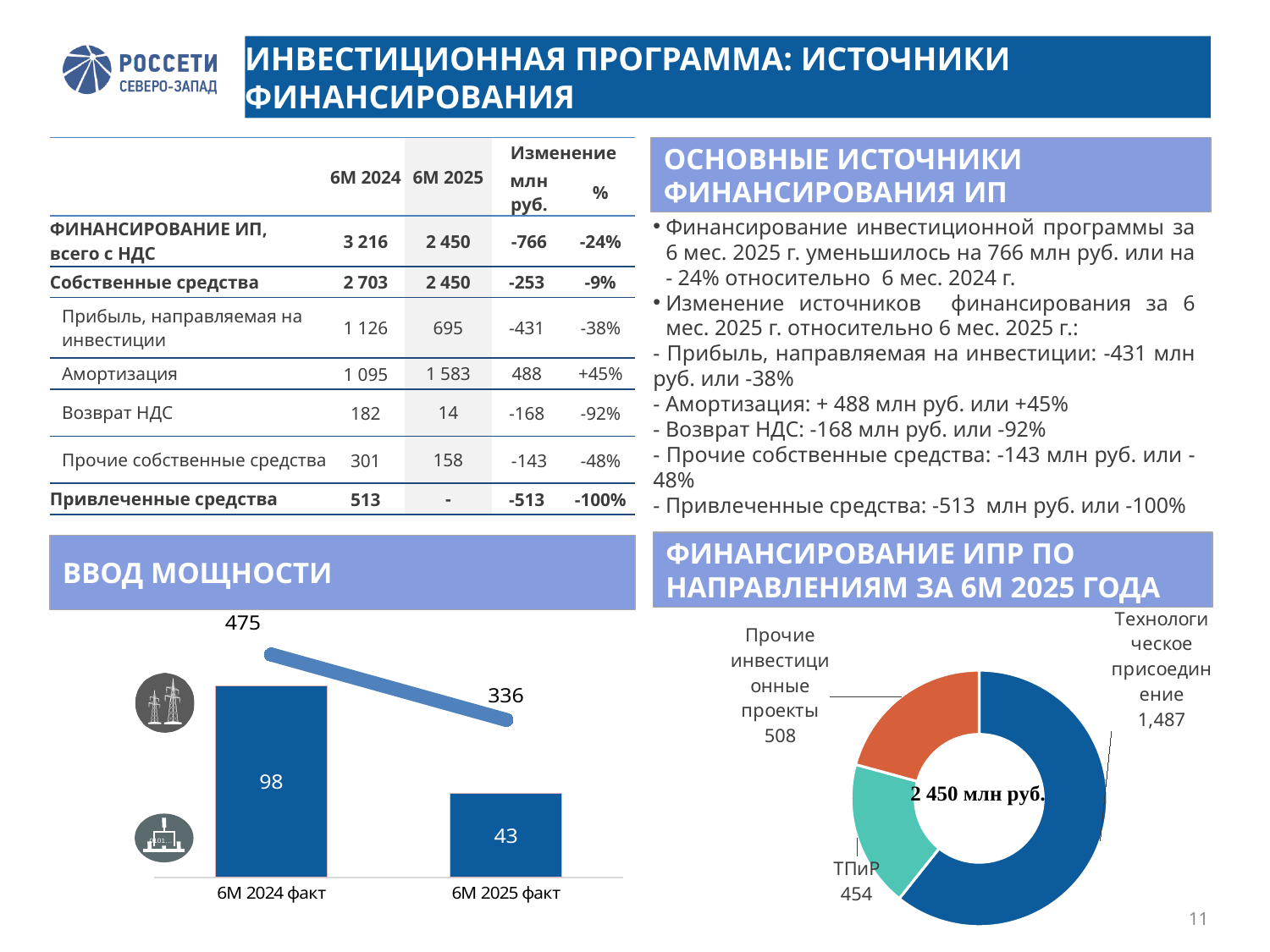
In the 'ФИНАНСИРОВАНИЕ ИПР ПО НАПРАВЛЕНИЯМ ЗА 6М 2025 ГОДА' chart, which segment is the smallest? ТПиР In the 'ВВОД МОЩНОСТИ' chart, what value is labelled above the 6М 2024 факт bar? 475 What kind of chart is 'ВВОД МОЩНОСТИ'? combination bar and line chart In the 'ВВОД МОЩНОСТИ' chart, what is the difference between the bar values for 6М 2024 факт and 6М 2025 факт? 55 In the 'ФИНАНСИРОВАНИЕ ИПР ПО НАПРАВЛЕНИЯМ ЗА 6М 2025 ГОДА' chart, which is larger: Прочие инвестиционные проекты or ТПиР? Прочие инвестиционные проекты In the 'ВВОД МОЩНОСТИ' chart, what value is shown on the bar for 6М 2024 факт? 98 In the 'ВВОД МОЩНОСТИ' chart, what value is shown on the bar for 6М 2025 факт? 43 In the 'ВВОД МОЩНОСТИ' chart, what value is labelled above the 6М 2025 факт bar? 336 How many categories are shown on the x axis of the 'ВВОД МОЩНОСТИ' chart? 2 In the 'ВВОД МОЩНОСТИ' chart, do the bar values rise or fall from 6М 2024 факт to 6М 2025 факт? fall In the 'ФИНАНСИРОВАНИЕ ИПР ПО НАПРАВЛЕНИЯМ ЗА 6М 2025 ГОДА' chart, what total is shown in the centre of the doughnut? 2 450 млн руб. In the 'ФИНАНСИРОВАНИЕ ИПР ПО НАПРАВЛЕНИЯМ ЗА 6М 2025 ГОДА' chart, what is the value for Технологическое присоединение? 1,487